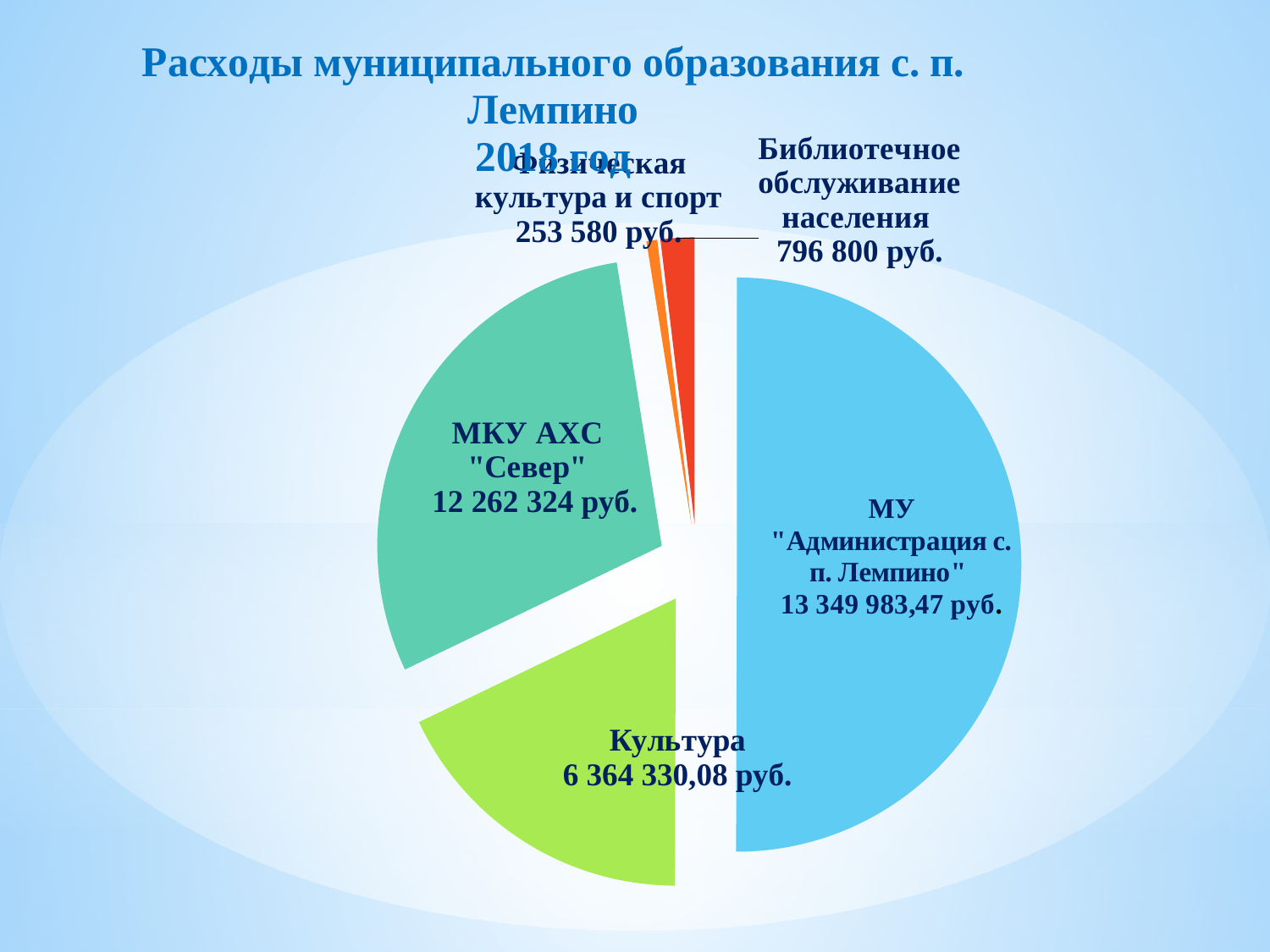
What is the value for МУ "Администрация с. п. Лемпино"? 13 349 983,47 руб. Which is larger: МКУ АХС "Север" or Культура? МКУ АХС "Север" What is the value for Физическая культура и спорт? 253 580 руб. How many categories are shown in the pie chart? 5 Which category has the smallest expenditure? Физическая культура и спорт What is the value for Культура? 6 364 330,08 руб. What type of chart is shown on the slide? Pie chart What is the value for Библиотечное обслуживание населения? 796 800 руб. What is the difference between Библиотечное обслуживание населения and Физическая культура и спорт? 543 220 руб. Which category has the largest expenditure? МУ "Администрация с. п. Лемпино" What is the difference between МКУ АХС "Север" and Культура? 5 897 993,92 руб. What is the value for МКУ АХС "Север"? 12 262 324 руб.